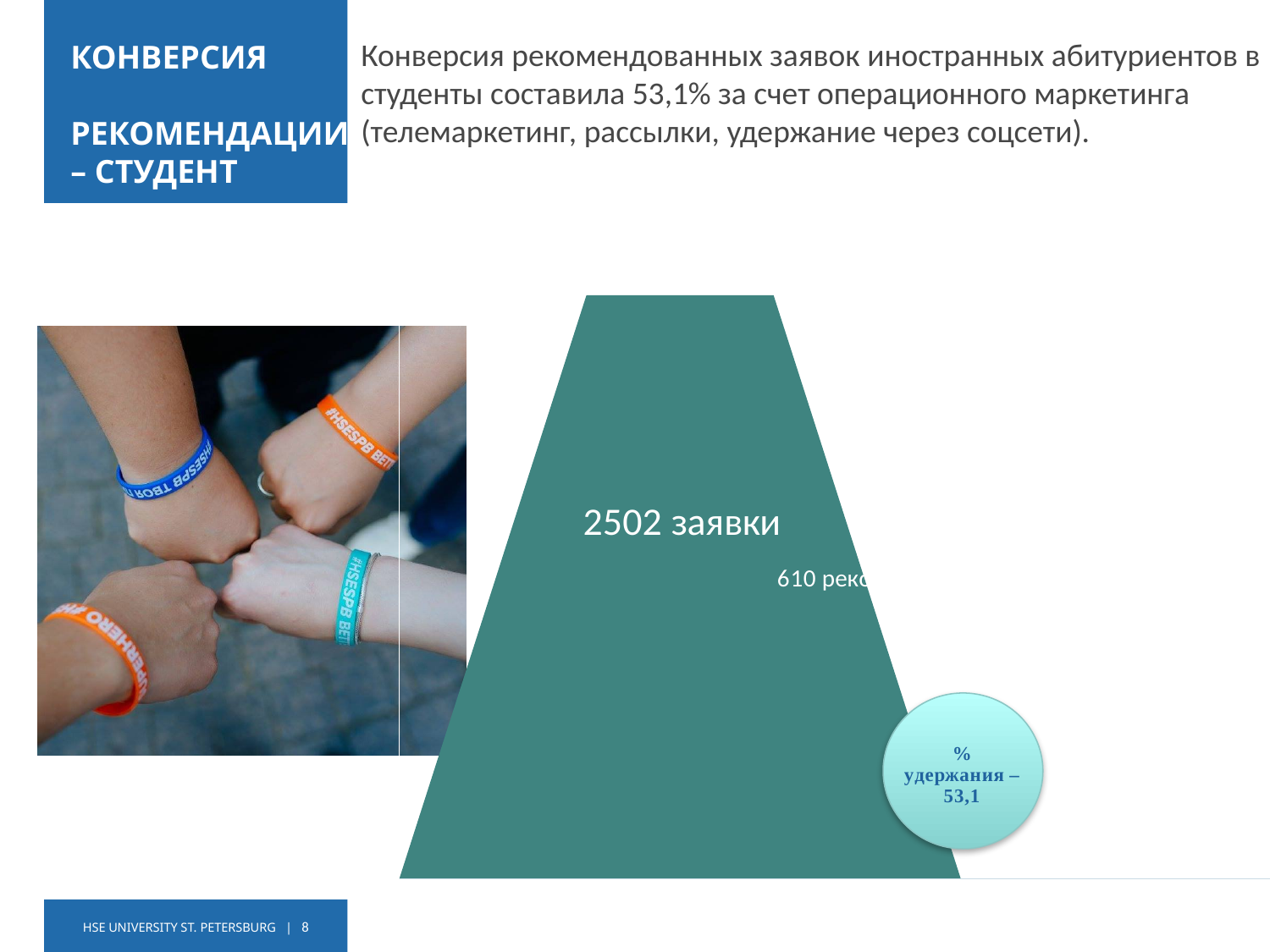
What kind of diagram is used on the slide to present the applications figure? A funnel diagram Is the number of applications shown in the funnel greater or less than 2000? greater What retention percentage (% удержания) is shown in the circle at the bottom right of the funnel? 53,1 What number of applications (заявки) is printed inside the funnel shape on the slide? 2502 заявки What colour is the funnel shape on the slide? Teal (dark green) Is the retention percentage shown in the circle greater or less than 50? greater